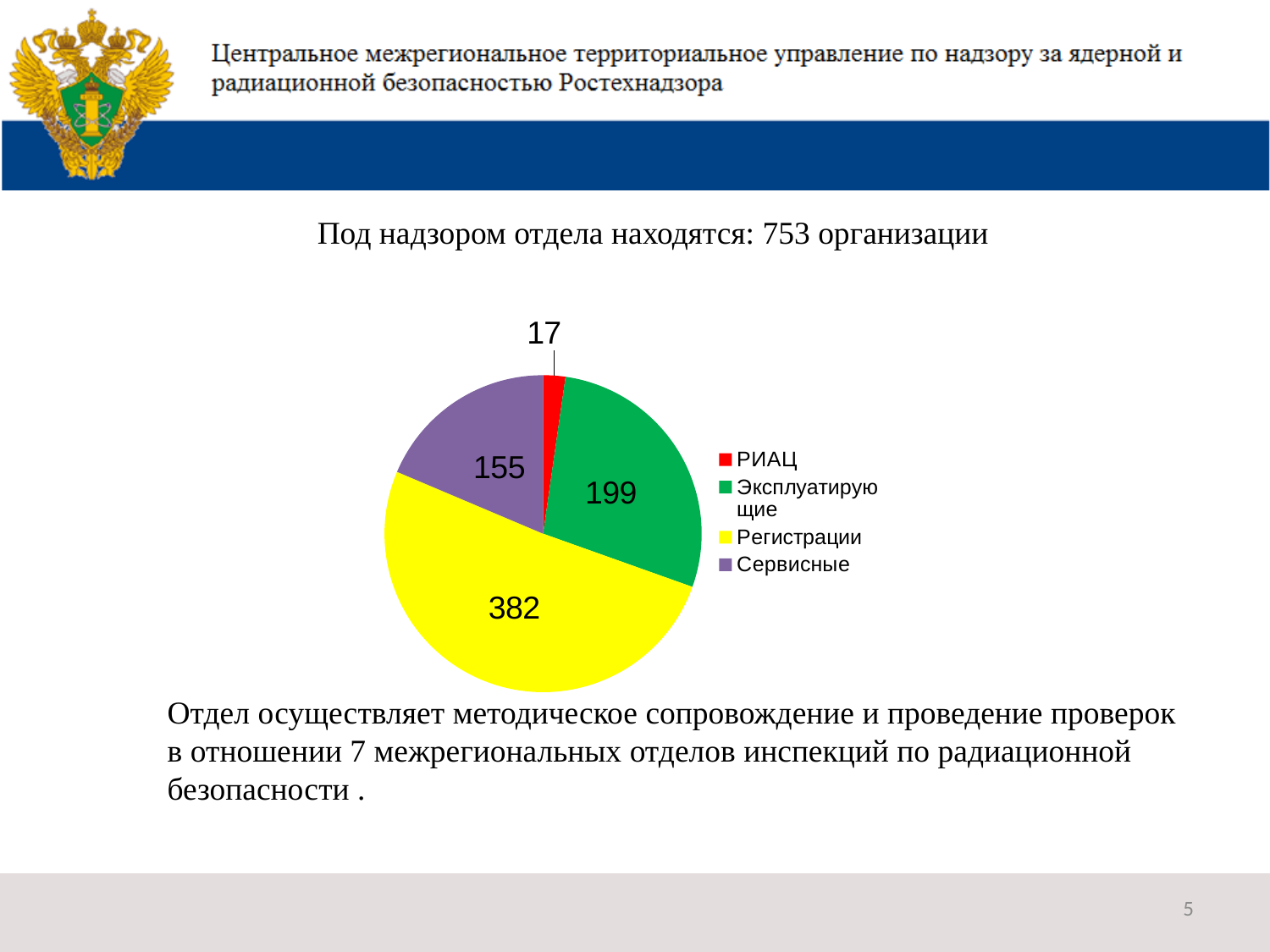
What is the value for РИАЦ in the pie chart? 17 How many slices does the pie chart have? 4 What kind of chart is shown on the slide? pie chart What is the value for Регистрации in the pie chart? 382 Which category has the largest slice in the pie chart? Регистрации What is the value for Эксплуатирующие in the pie chart? 199 What colour is the slice for Регистрации in the pie chart? yellow What is the value for Сервисные in the pie chart? 155 How many entries does the legend of the pie chart list? 4 What is the difference between the values for Регистрации and Эксплуатирующие? 183 Which category has the smallest slice in the pie chart? РИАЦ Which is larger, the value for Эксплуатирующие or the value for Сервисные? Эксплуатирующие